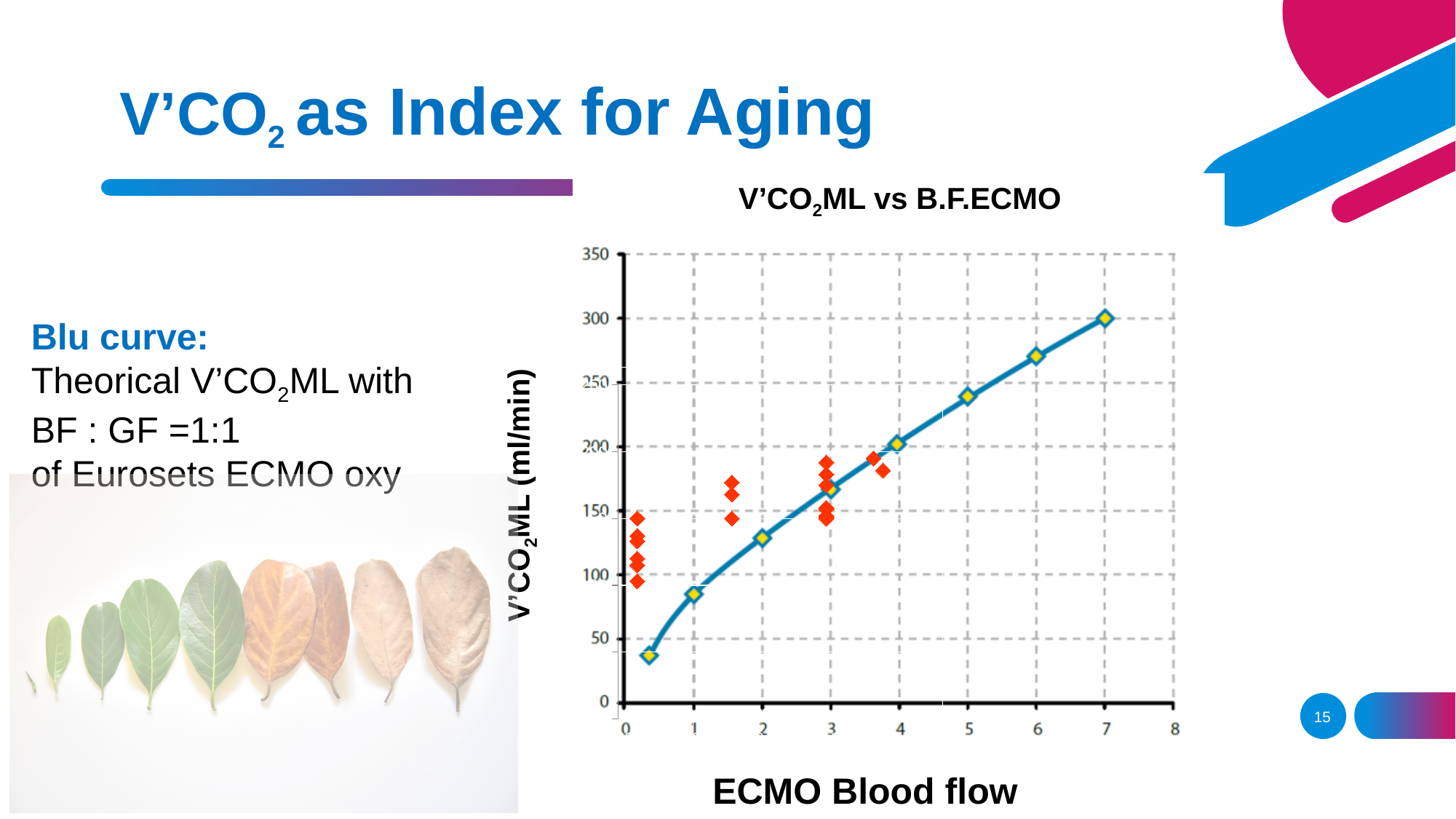
Is the value of the blue curve at ECMO Blood flow 5 greater or less than 200? greater Is the value of the blue curve at ECMO Blood flow 1 greater or less than 100? less At which ECMO Blood flow value does the blue curve reach its highest point? 7 Is the value of the blue curve at ECMO Blood flow 6 greater or less than 300? less Does the blue curve rise or fall as ECMO Blood flow increases? rises What is the label of the x axis of the chart? ECMO Blood flow What is the title of the chart? V'CO2ML vs B.F.ECMO Which is larger on the blue curve: the value at ECMO Blood flow 4 or at ECMO Blood flow 2? ECMO Blood flow 4 What type of chart is shown on the slide? line chart How many yellow diamond markers are on the blue curve? 8